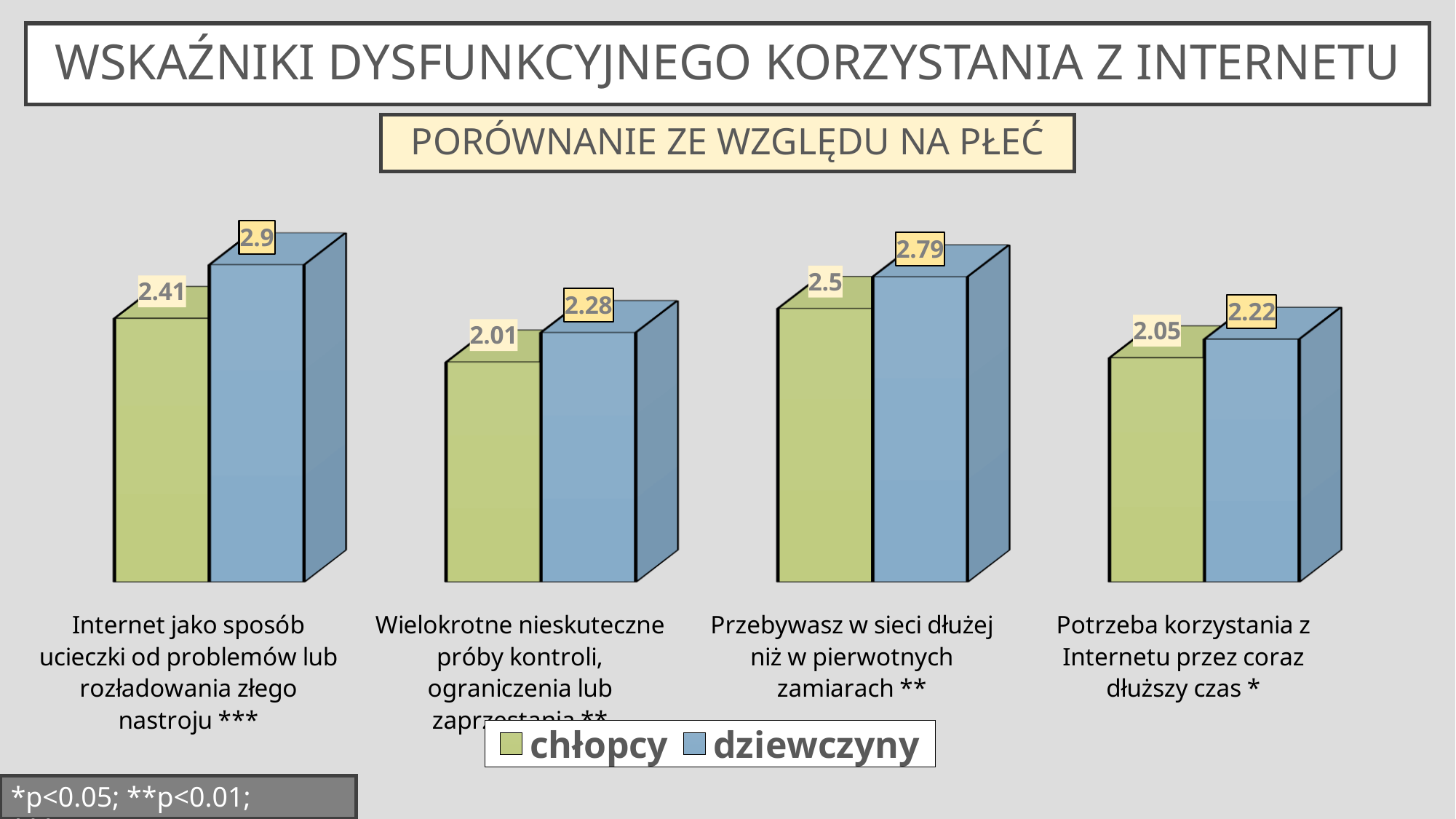
Which category has the highest value for dziewczyny? Internet jako sposób ucieczki od problemów lub rozładowania złego nastroju What kind of chart is shown on the slide? bar chart Which category has the lowest value for chłopcy? Wielokrotne nieskuteczne próby kontroli, ograniczenia lub zaprzestania How many series does the legend list? 2 In the category "Potrzeba korzystania z Internetu przez coraz dłuższy czas", which series has the larger value, chłopcy or dziewczyny? dziewczyny What is the value for dziewczyny in the category "Internet jako sposób ucieczki od problemów lub rozładowania złego nastroju"? 2.9 What is the value for dziewczyny in the category "Potrzeba korzystania z Internetu przez coraz dłuższy czas"? 2.22 What is the value for chłopcy in the category "Wielokrotne nieskuteczne próby kontroli, ograniczenia lub zaprzestania"? 2.01 What is the value for chłopcy in the category "Przebywasz w sieci dłużej niż w pierwotnych zamiarach"? 2.5 What is the difference between the dziewczyny and chłopcy values in the category "Internet jako sposób ucieczki od problemów lub rozładowania złego nastroju"? 0.49 What is the difference between the dziewczyny and chłopcy values in the category "Przebywasz w sieci dłużej niż w pierwotnych zamiarach"? 0.29 How many categories are shown in the chart? 4